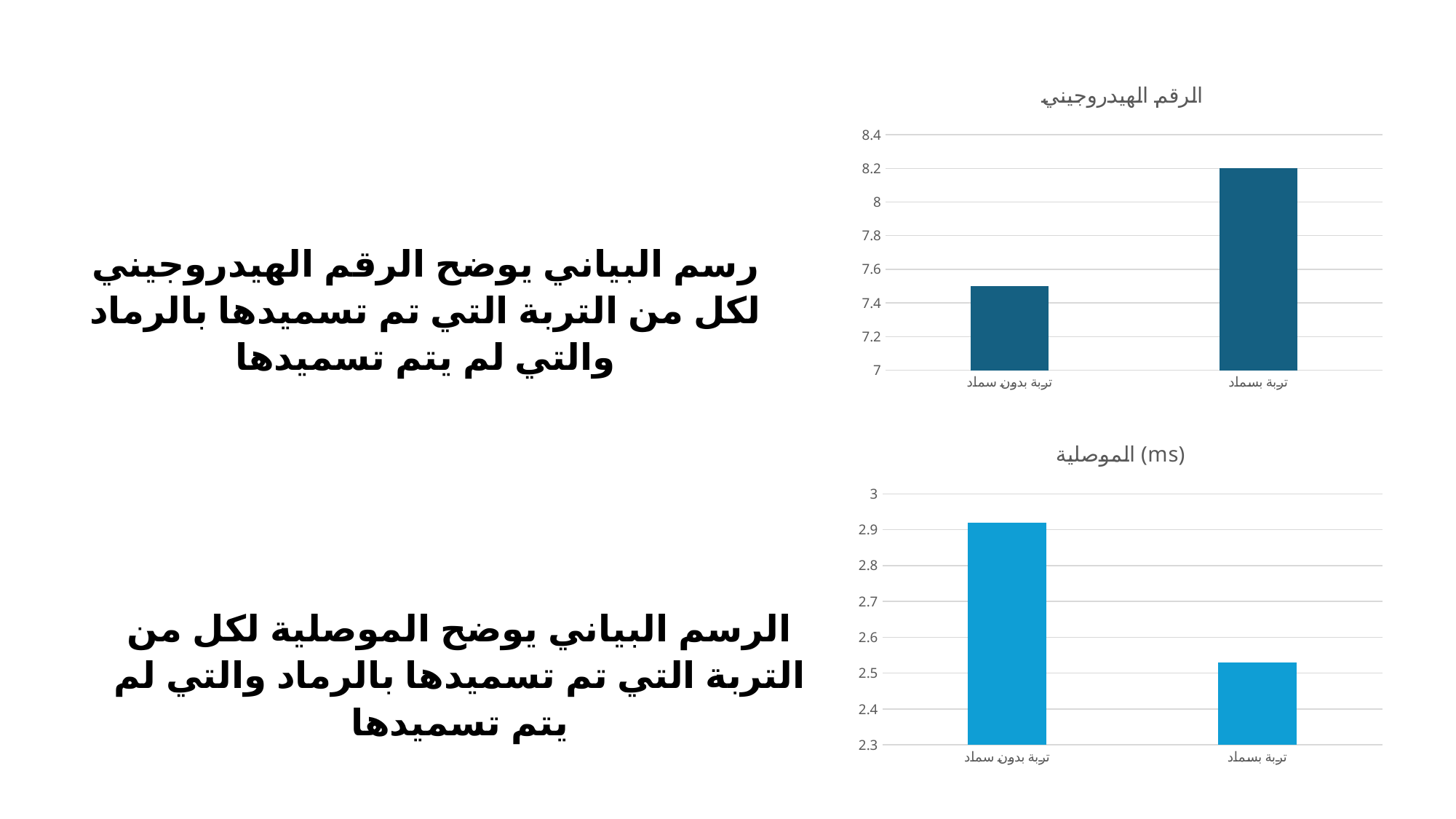
In the bottom chart titled الموصلية (ms), is the value for تربة بسماد greater or less than 2.6? less What is the title of the bottom chart on the slide? الموصلية (ms) In the bottom chart titled الموصلية (ms), which is larger, the value for تربة بدون سماد or the value for تربة بسماد? تربة بدون سماد In the top chart titled الرقم الهيدروجيني, which category has the highest value? تربة بسماد What kind of chart is the bottom chart titled الموصلية (ms)? bar chart In the top chart titled الرقم الهيدروجيني, what is the value for تربة بسماد? 8.2 In the top chart titled الرقم الهيدروجيني, which category has the lowest value? تربة بدون سماد In the top chart titled الرقم الهيدروجيني, is the value for تربة بدون سماد greater or less than 7.6? less What kind of chart is the top chart titled الرقم الهيدروجيني? bar chart In the bottom chart titled الموصلية (ms), which category has the highest value? تربة بدون سماد In the top chart titled الرقم الهيدروجيني, how many categories are shown? 2 In the bottom chart titled الموصلية (ms), is the value for تربة بدون سماد greater or less than 2.8? greater